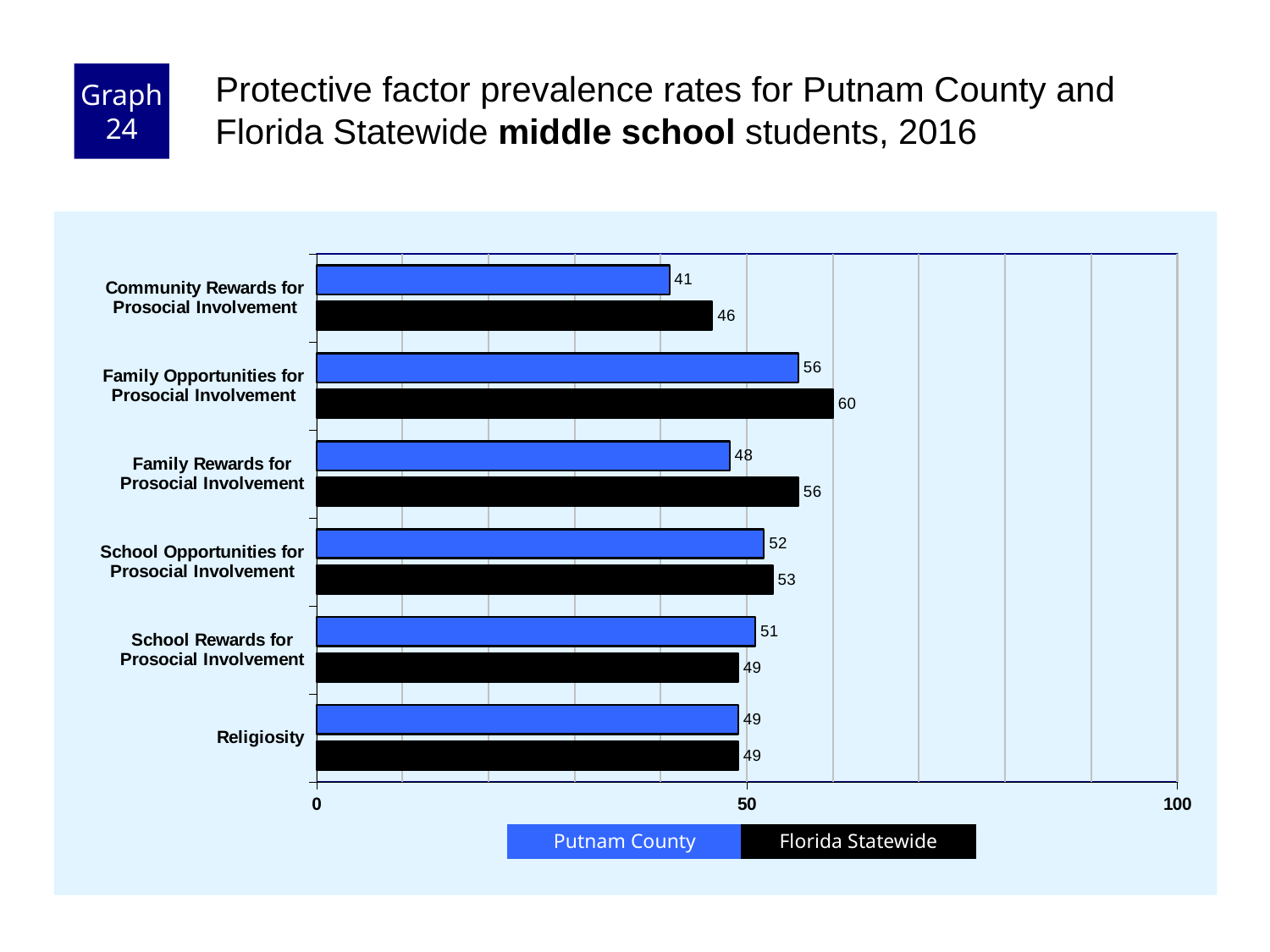
Is the Putnam County value for Family Opportunities for Prosocial Involvement greater or less than 50? greater For School Rewards for Prosocial Involvement, which is larger: the Putnam County value or the Florida Statewide value? Putnam County What is the Putnam County value for Community Rewards for Prosocial Involvement? 41 Which category has the lowest Putnam County value? Community Rewards for Prosocial Involvement What is the Florida Statewide value for Family Opportunities for Prosocial Involvement? 60 How many series does the legend list? 2 Which colour represents Florida Statewide in the chart? Black How many categories are shown on the chart? 6 Which category has the highest Florida Statewide value? Family Opportunities for Prosocial Involvement What kind of chart is shown on the slide? Bar chart What is the difference between the Florida Statewide and Putnam County values for Family Rewards for Prosocial Involvement? 8 What is the Florida Statewide value for Family Rewards for Prosocial Involvement? 56